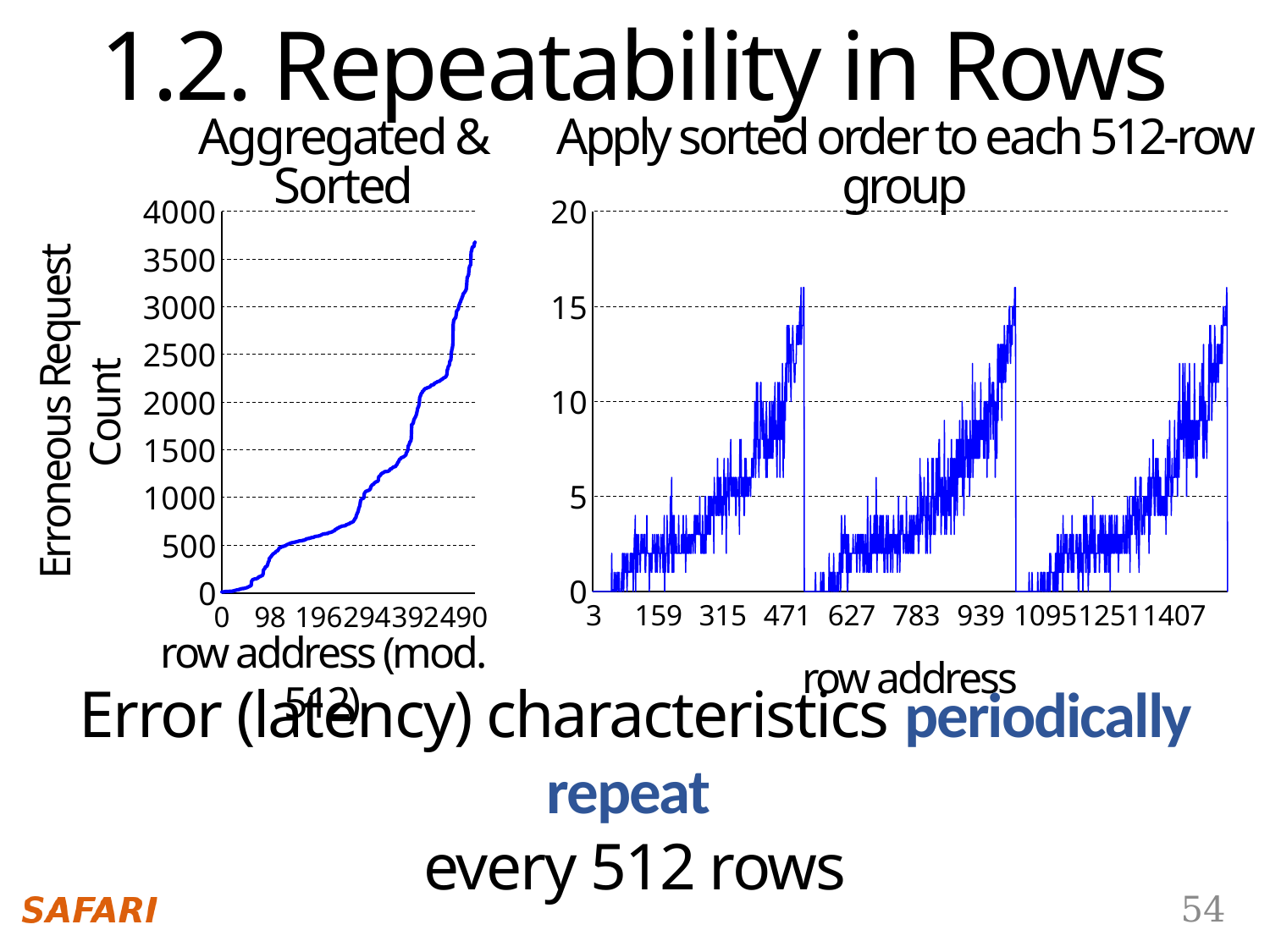
In the left chart "Aggregated & Sorted", do the values rise or fall as the row address increases along the x axis? rise In the right chart "Apply sorted order to each 512-row group", what is the highest value shown on the y axis? 20 What kind of chart is the right chart titled "Apply sorted order to each 512-row group"? line chart In the left chart "Aggregated & Sorted", is the value at row address 294 greater or less than 1500? less In the right chart "Apply sorted order to each 512-row group", is the value at row address 159 greater or less than 5? less In the right chart "Apply sorted order to each 512-row group", how many repeating 512-row groups are plotted? 3 In the right chart "Apply sorted order to each 512-row group", is the peak value just before row address 512 greater or less than 15? greater In the left chart "Aggregated & Sorted", what is the highest value shown on the y axis? 4000 What kind of chart is the left chart titled "Aggregated & Sorted"? line chart What is the y-axis label of the left chart "Aggregated & Sorted"? Erroneous Request Count